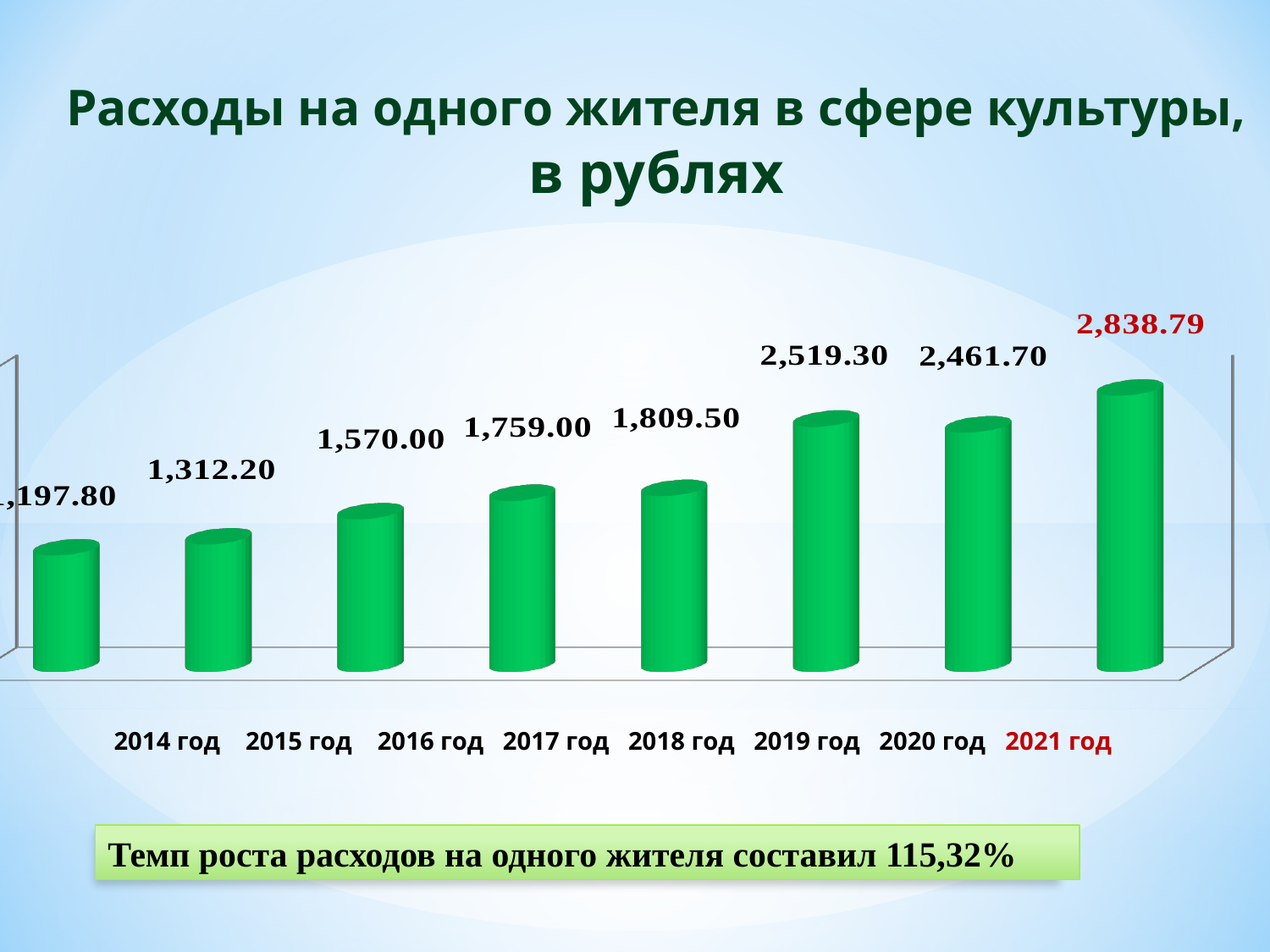
Which year has the lowest value? 2014 год What is the value for 2019 год? 2,519.30 Which is larger, the value for 2019 год or 2020 год? 2019 год Which year has the highest value? 2021 год What is the title of the chart? Расходы на одного жителя в сфере культуры, в рублях What is the difference between the values for 2019 год and 2020 год? 57.60 How many years are shown on the chart? 8 What kind of chart is shown on the slide? Bar chart What is the value for 2021 год? 2,838.79 What is the difference between the values for 2021 год and 2020 год? 377.09 What is the value for 2016 год? 1,570.00 What is the value for 2018 год? 1,809.50